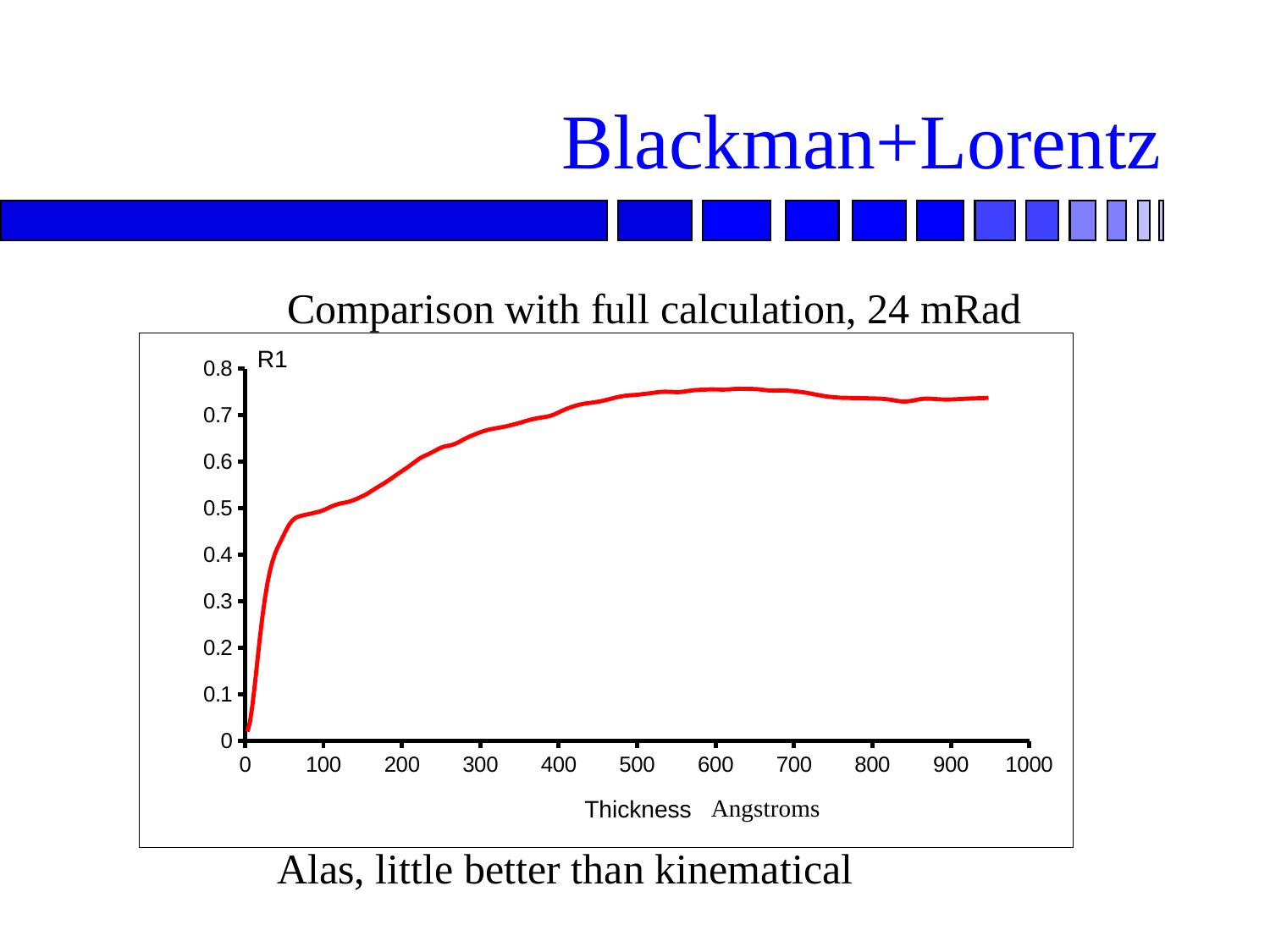
Which thickness has the larger R1 value, 100 Angstroms or 500 Angstroms? 500 Angstroms Is the R1 value at a thickness of 200 Angstroms greater or less than 0.5? greater Does the plotted R1 value generally rise or fall as thickness increases from 0 to 500 Angstroms? rise Is the R1 value at a thickness of 100 Angstroms greater or less than 0.4? greater What kind of chart is shown on the slide? line chart Is the R1 value at a thickness of 900 Angstroms greater or less than 0.7? greater What is the label on the x axis of the chart? Thickness Angstroms What is the title of the chart? Comparison with full calculation, 24 mRad Which thickness has the larger R1 value, 50 Angstroms or 300 Angstroms? 300 Angstroms What is the highest value shown on the y axis of the chart? 0.8